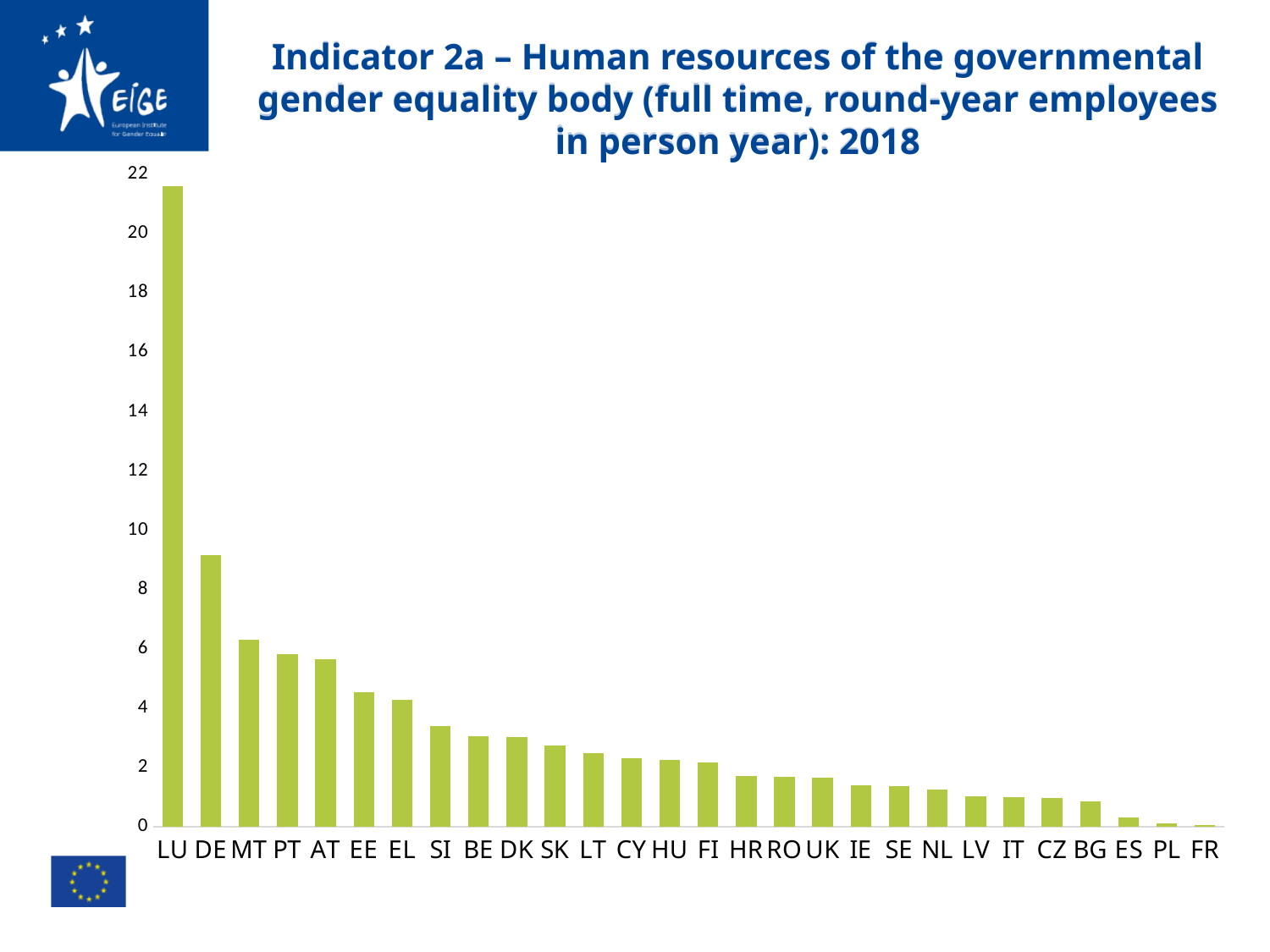
Which country has the highest value in the chart? LU How many countries are shown on the x axis of the chart? 28 Is the value for SI greater or less than 4? less Is the value for DE greater or less than 8? greater Is the value for DE greater or less than 10? less Which has the larger value, DE or MT? DE What kind of chart is shown on the slide? bar chart Do the values rise or fall moving from left to right along the x axis? fall Which country has the lowest value in the chart? FR